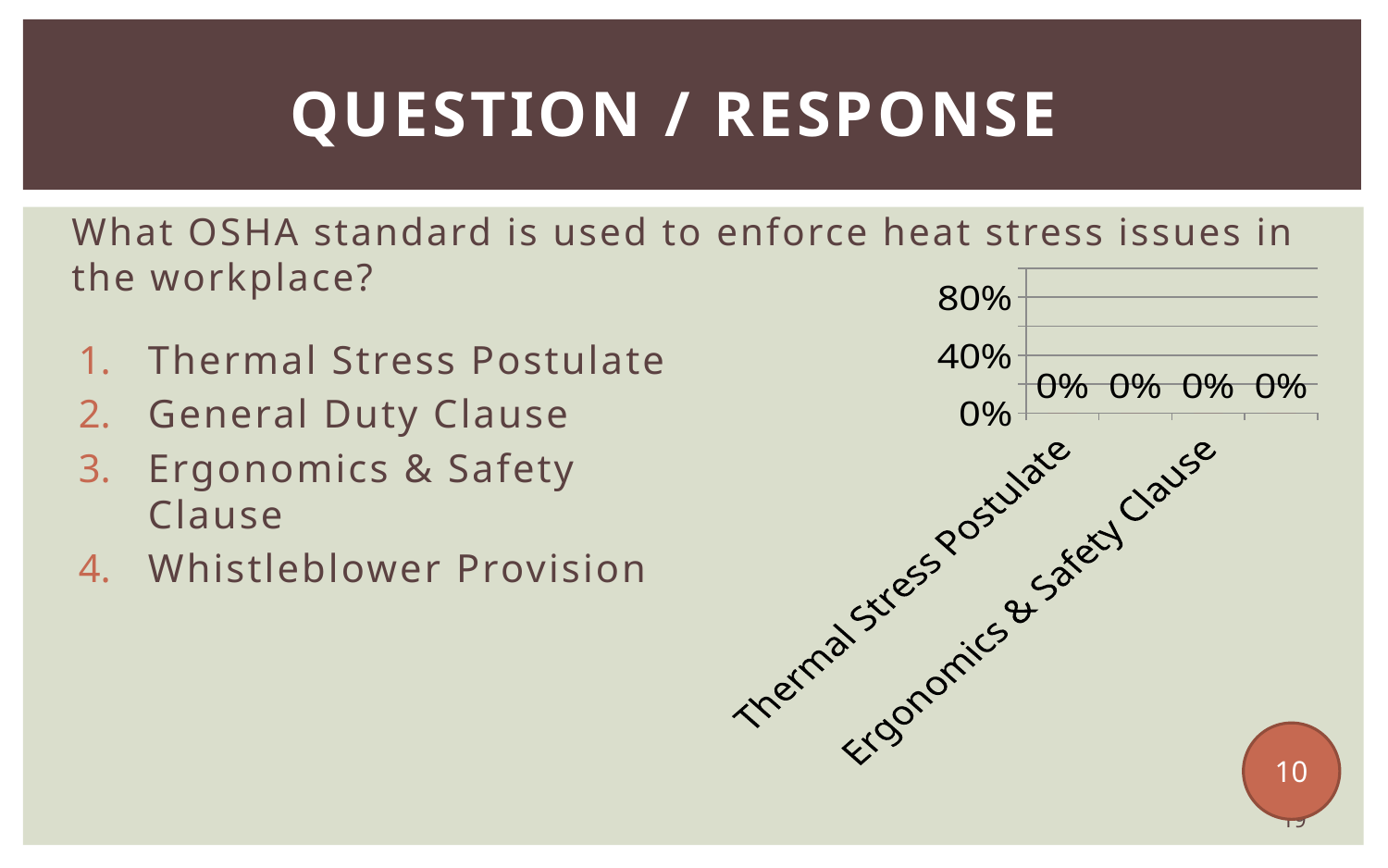
What is the highest tick label shown on the chart's vertical axis? 80% What is the difference between the values for Thermal Stress Postulate and Ergonomics & Safety Clause? 0% What value is shown for Thermal Stress Postulate in the chart? 0% What is the lowest tick label shown on the chart's vertical axis? 0% Is the value for Thermal Stress Postulate greater or less than 40%? less What value is shown for Ergonomics & Safety Clause in the chart? 0% Is the value for Ergonomics & Safety Clause greater or less than 40%? less What kind of chart is shown on the slide? bar chart How many data labels are shown on the chart? 4